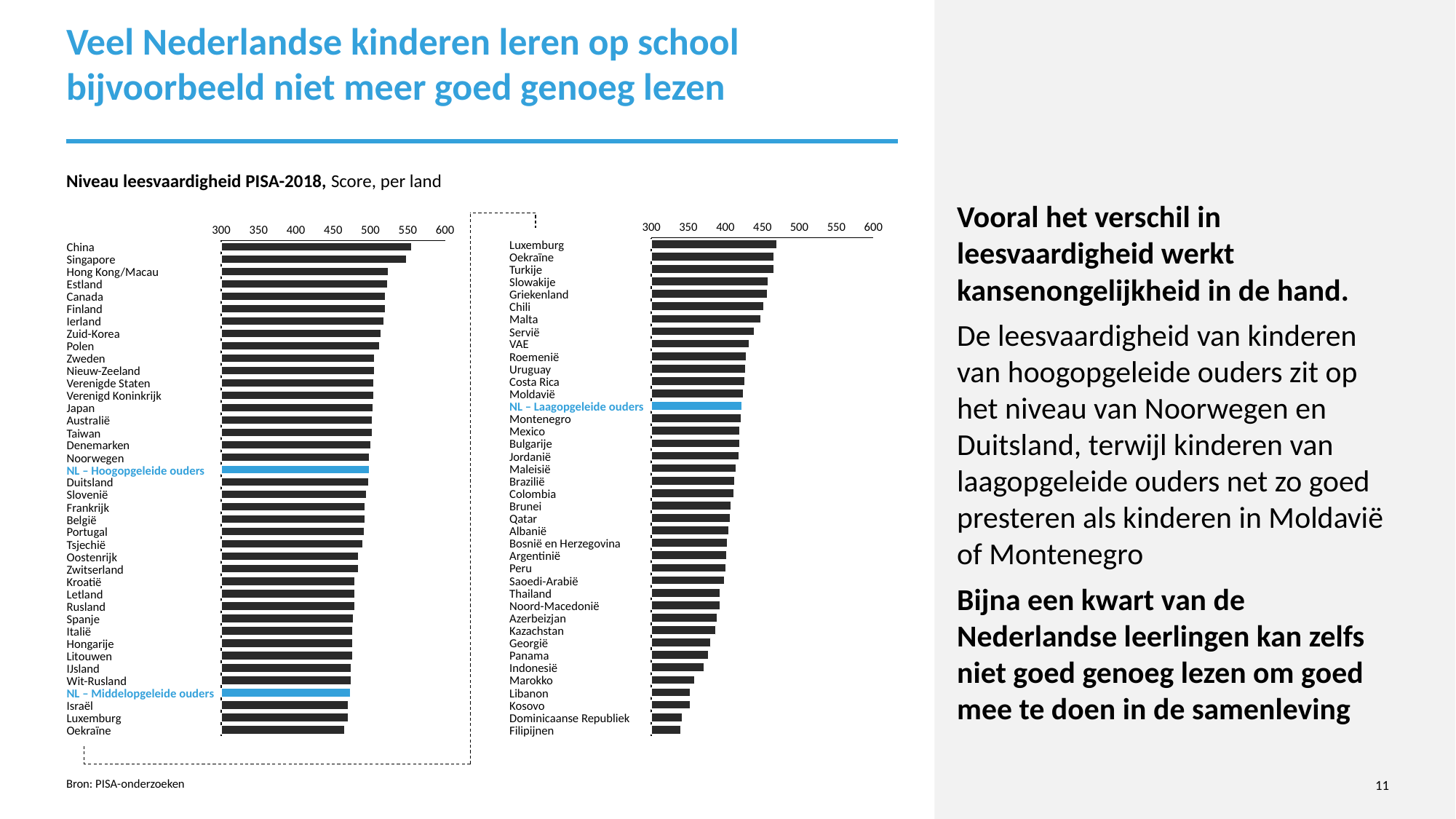
In the left chart, is the value for NL – Middelopgeleide ouders greater or less than 500? less In the right chart, which has a higher reading score: Luxemburg or Filipijnen? Luxemburg In the left chart, is the value for NL – Hoogopgeleide ouders greater or less than 450? greater In the left chart, which country has the highest reading score? China In the right chart, which category has the highest reading score? Luxemburg In the right chart, is the value for NL – Laagopgeleide ouders greater or less than 450? less What type of chart is used on this slide to show the PISA-2018 reading scores? Bar chart Which has a higher reading score: NL – Hoogopgeleide ouders (left chart) or NL – Laagopgeleide ouders (right chart)? NL – Hoogopgeleide ouders In the right chart, which country has the lowest reading score? Filipijnen What is the title of the chart on this slide? Niveau leesvaardigheid PISA-2018, Score, per land